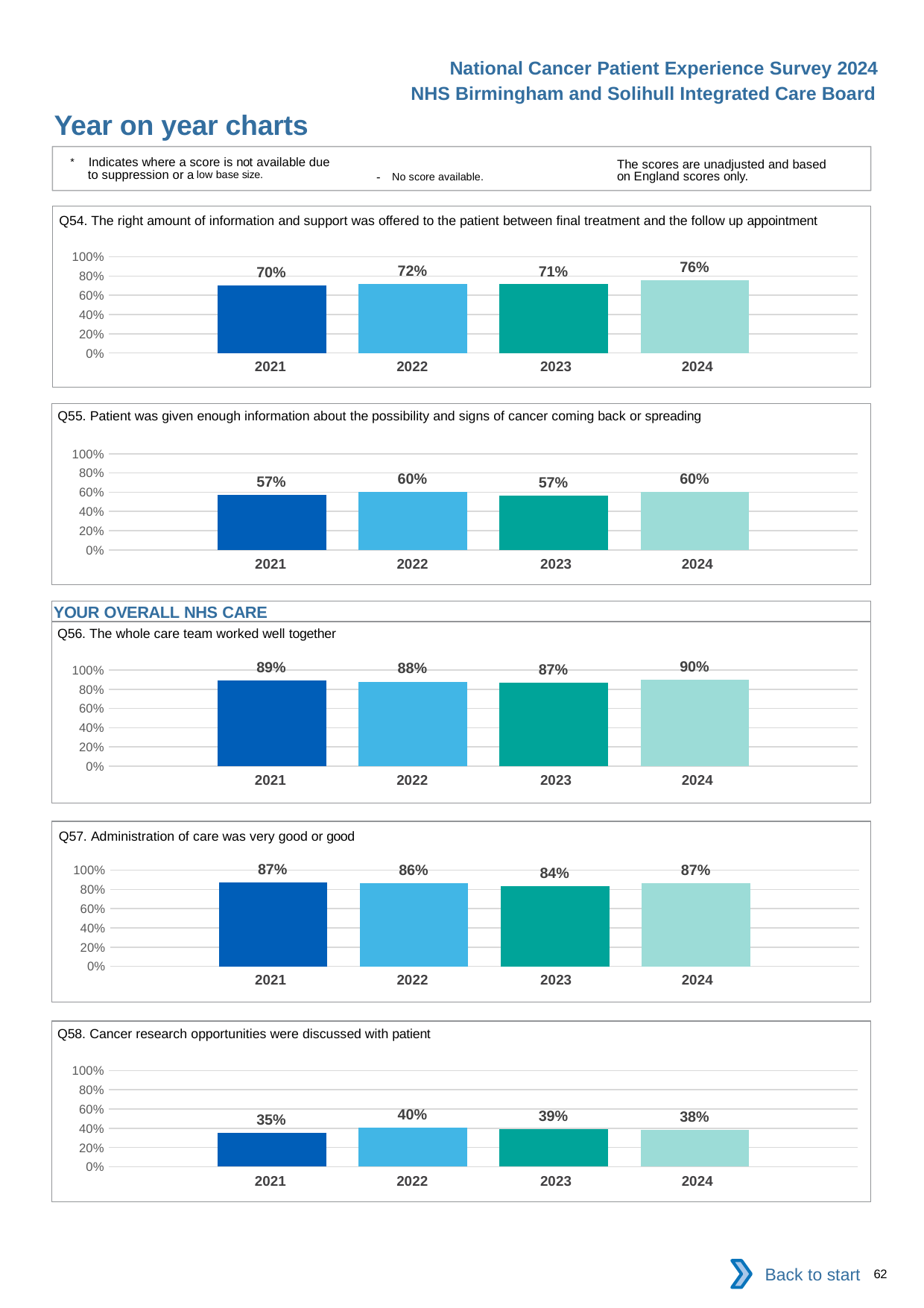
In the Q55 chart, what is the value for 2023? 57% In the Q57 chart, what is the difference between the 2021 and 2023 values? 3% In the Q55 chart, what is the difference between the 2022 and 2021 values? 3% In the Q56 chart, what is the value for 2022? 88% In the Q58 chart, what is the value for 2021? 35% In the Q56 chart, which year has the highest value? 2024 In the Q54 chart, what is the value for 2024? 76% What type of chart is the Q54 chart? Bar chart How many years are shown on the x axis of the Q58 chart? 4 In the Q54 chart, which year has the lowest value? 2021 In the Q57 chart, which is larger, the value for 2022 or the value for 2023? 2022 In the Q58 chart, which year has the highest value? 2022